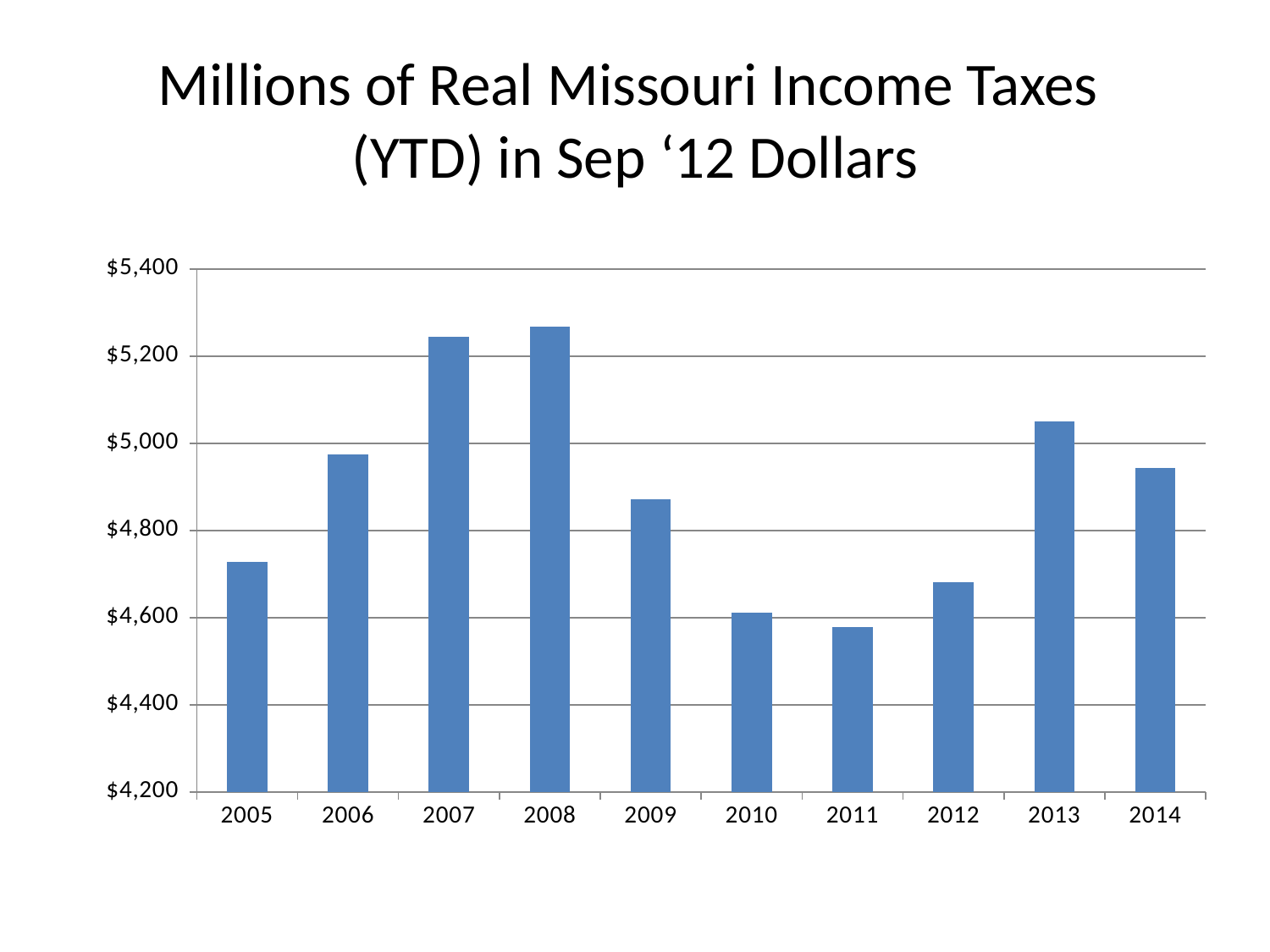
Is the value for 2007 greater or less than $5,200? greater Is the value for 2012 greater or less than $4,800? less What kind of chart is shown on the slide? bar chart Which year has the larger value, 2009 or 2012? 2009 What is the title of the chart? Millions of Real Missouri Income Taxes (YTD) in Sep '12 Dollars Is the value for 2013 greater or less than $5,000? greater How many years are plotted on the chart? 10 Which year has the larger value, 2013 or 2014? 2013 Do the values rise or fall from 2008 to 2011? fall